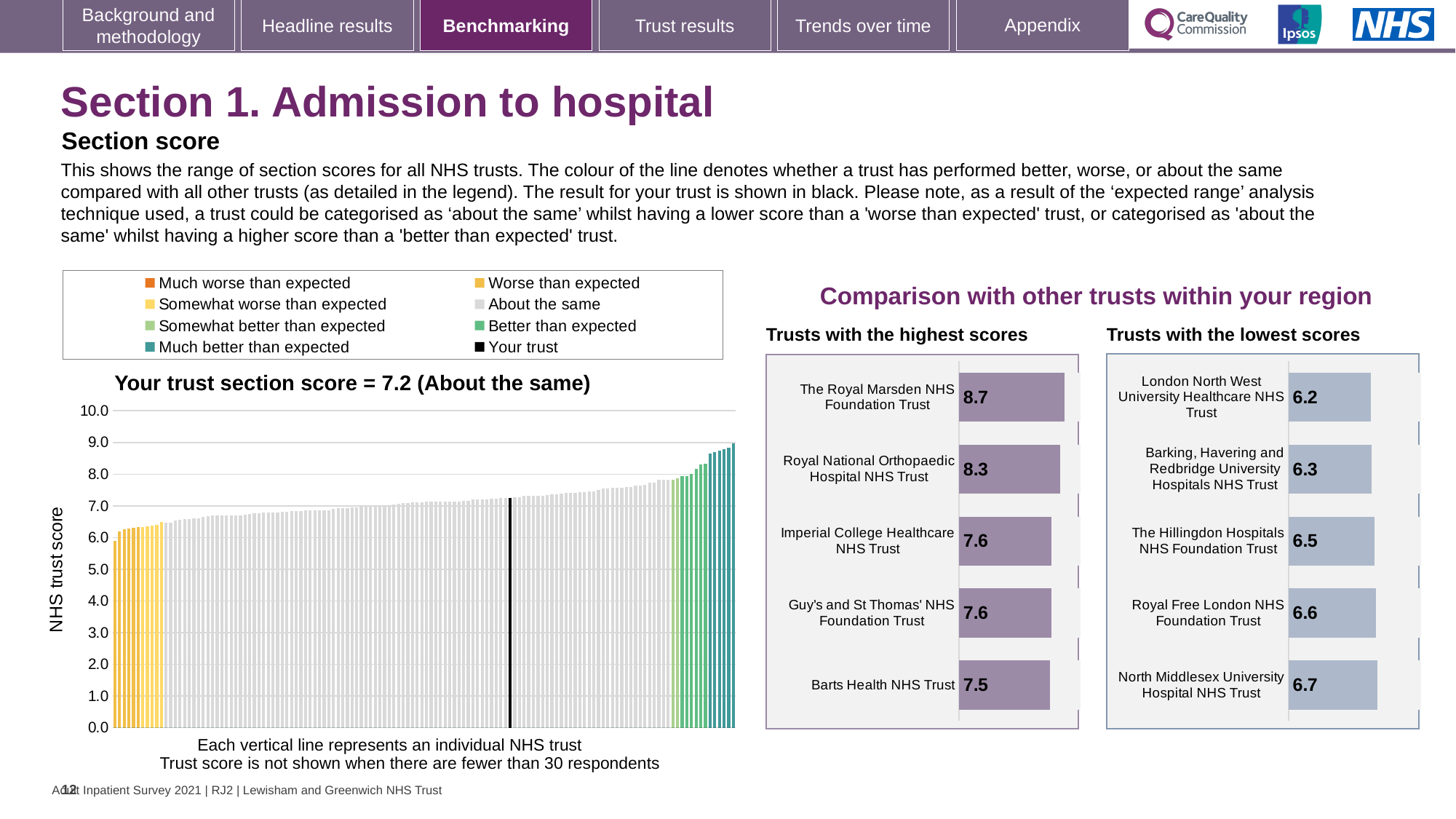
On the 'Trusts with the highest scores' chart, what is the score for The Royal Marsden NHS Foundation Trust? 8.7 On the 'Your trust section score' chart, what is the section score for your trust? 7.2 On the 'Your trust section score' chart, how many entries does the legend list? 8 On the 'Trusts with the lowest scores' chart, which has the higher score: Royal Free London NHS Foundation Trust or The Hillingdon Hospitals NHS Foundation Trust? Royal Free London NHS Foundation Trust On the 'Your trust section score' chart, what kind of chart is used to show the trust scores? bar chart On the 'Your trust section score' chart, is the value of the highest bar greater or less than 8.0? greater On the 'Trusts with the highest scores' chart, how many trusts are shown? 5 On the 'Your trust section score' chart, do the trust scores rise or fall from left to right? rise On the 'Trusts with the lowest scores' chart, which trust has the lowest score? London North West University Healthcare NHS Trust On the 'Trusts with the lowest scores' chart, what is the score for North Middlesex University Hospital NHS Trust? 6.7 On the 'Trusts with the highest scores' chart, what is the difference between the scores of The Royal Marsden NHS Foundation Trust and Barts Health NHS Trust? 1.2 On the 'Your trust section score' chart, what is the label on the vertical axis? NHS trust score